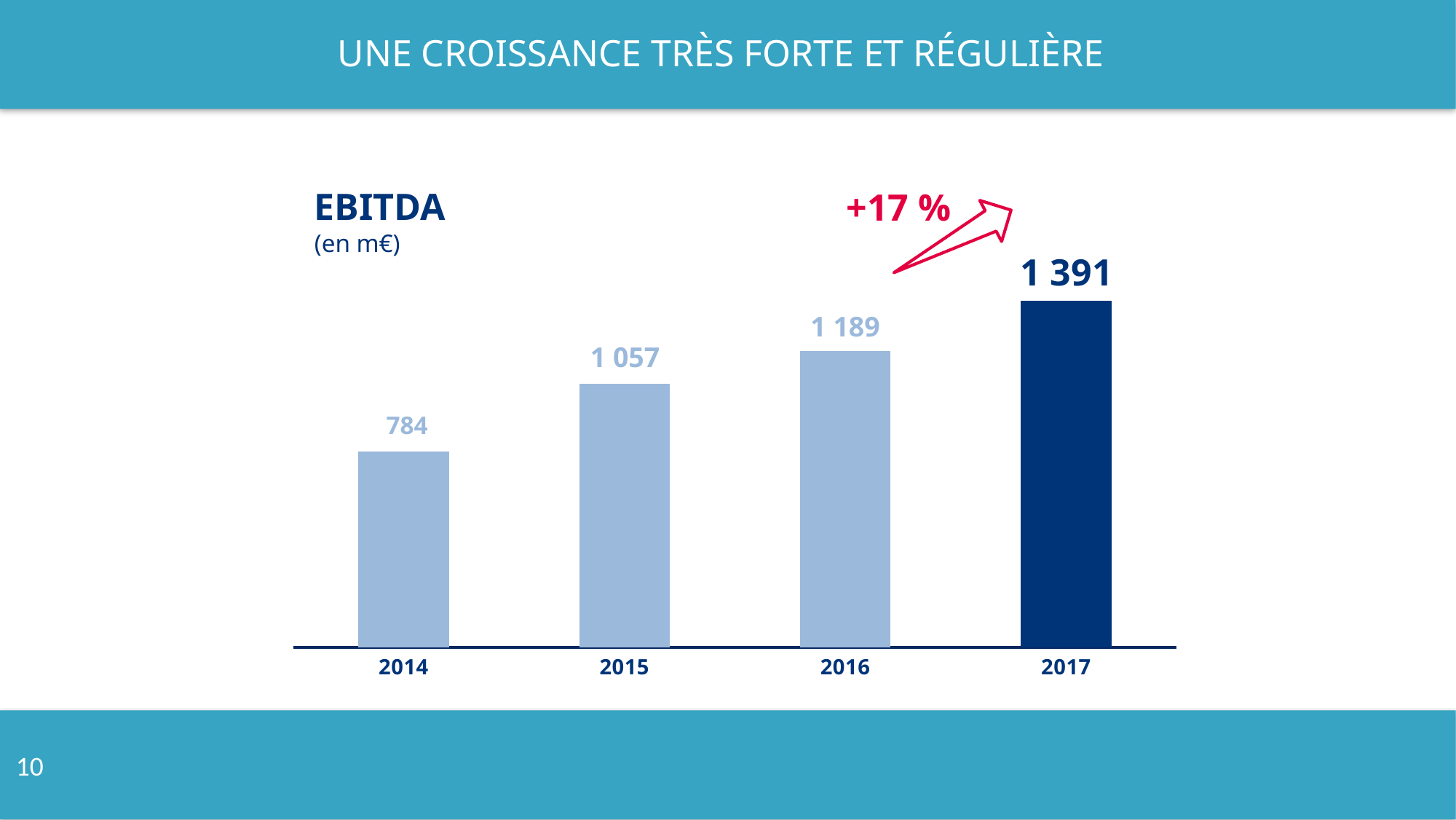
Which year has the highest EBITDA? 2017 What is the EBITDA value for 2016? 1 189 Which year has a larger EBITDA, 2015 or 2016? 2016 How many years are shown on the chart? 4 What is the difference in EBITDA between 2017 and 2016? 202 Do EBITDA values rise or fall from 2014 to 2017? Rise What is the EBITDA value for 2017? 1 391 What is the EBITDA value for 2015? 1 057 What kind of chart is shown on the slide? Bar chart Which year has the lowest EBITDA? 2014 What is the difference in EBITDA between 2015 and 2014? 273 What is the EBITDA value for 2014? 784